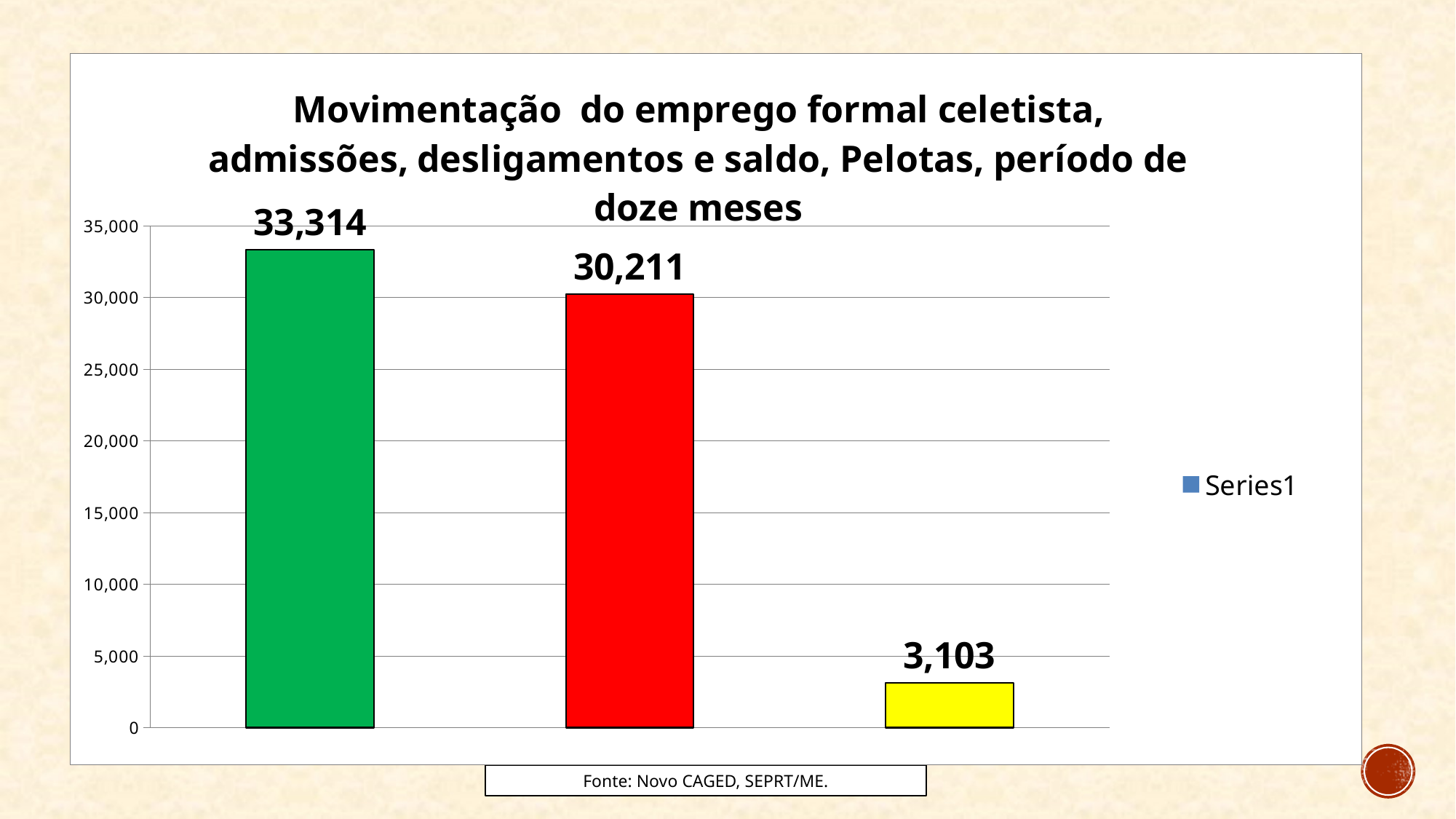
What is the value shown on the red bar? 30,211 Which is larger, the value of the green bar or the value of the red bar? green bar Which bar has the highest value: the green, red or yellow one? green What kind of chart is shown on the slide? bar chart What is the value shown on the yellow bar? 3,103 How many bars are plotted in the chart? 3 Which bar has the lowest value: the green, red or yellow one? yellow What is the value shown on the green bar? 33,314 What is the name of the series listed in the legend? Series1 What is the difference between the green bar's value and the red bar's value? 3,103 What is the difference between the red bar's value and the yellow bar's value? 27,108 Is the value of the yellow bar greater or less than 5,000? less